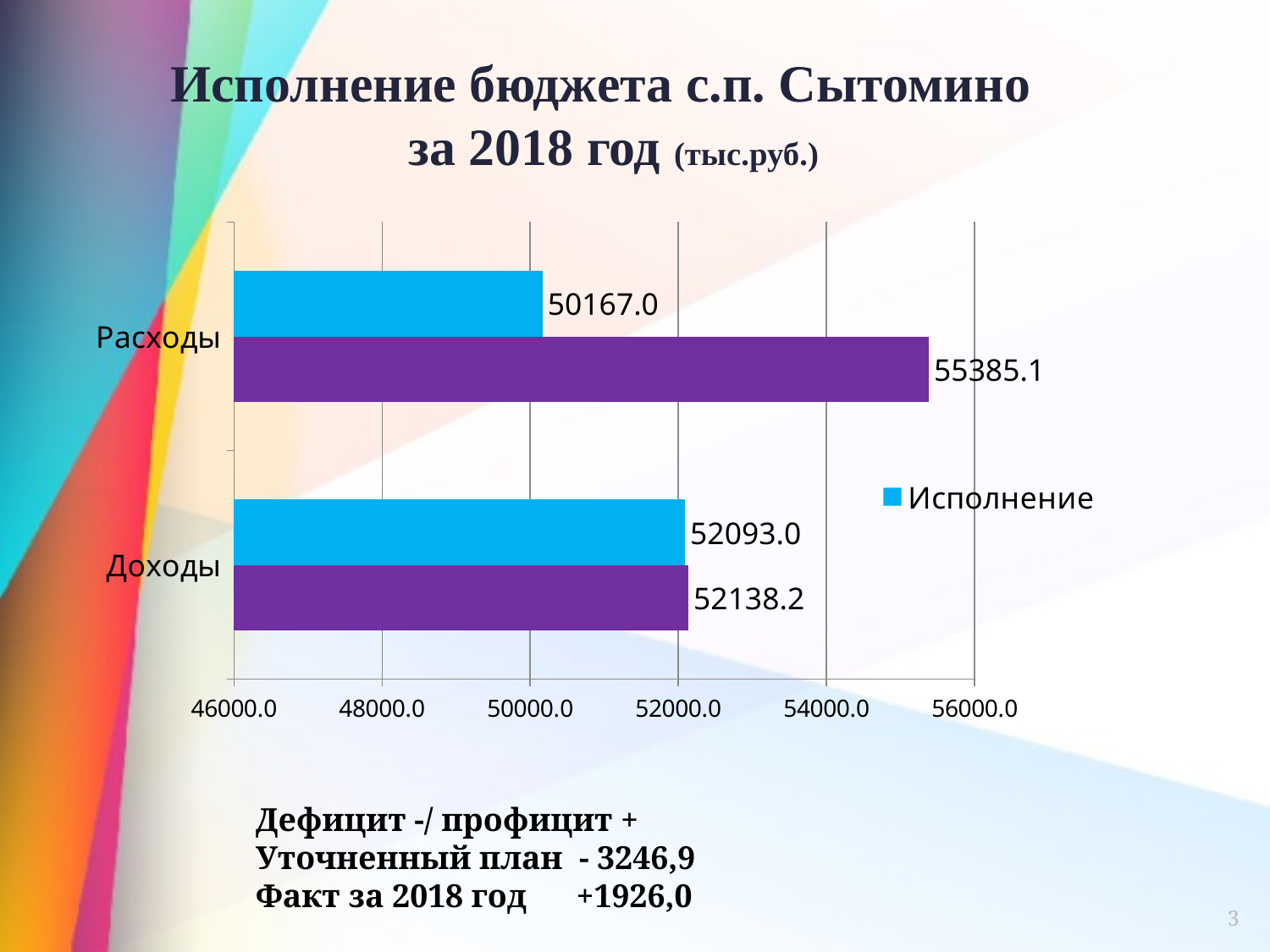
What kind of chart is shown on the slide? bar chart What is the difference between the purple bar and the Исполнение bar for Расходы? 5218.1 What is the difference between the Исполнение values for Доходы and Расходы? 1926.0 Is the Исполнение value for Расходы greater or less than 52000.0? less What value is shown on the purple bar for Доходы? 52138.2 How many categories are shown on the chart? 2 What is the Исполнение value for Расходы? 50167.0 Which category has the higher Исполнение value, Расходы or Доходы? Доходы For Расходы, which bar is larger, the purple bar or the Исполнение bar? the purple bar What value is shown on the purple bar for Расходы? 55385.1 What is the difference between the purple bar and the Исполнение bar for Доходы? 45.2 What is the Исполнение value for Доходы? 52093.0